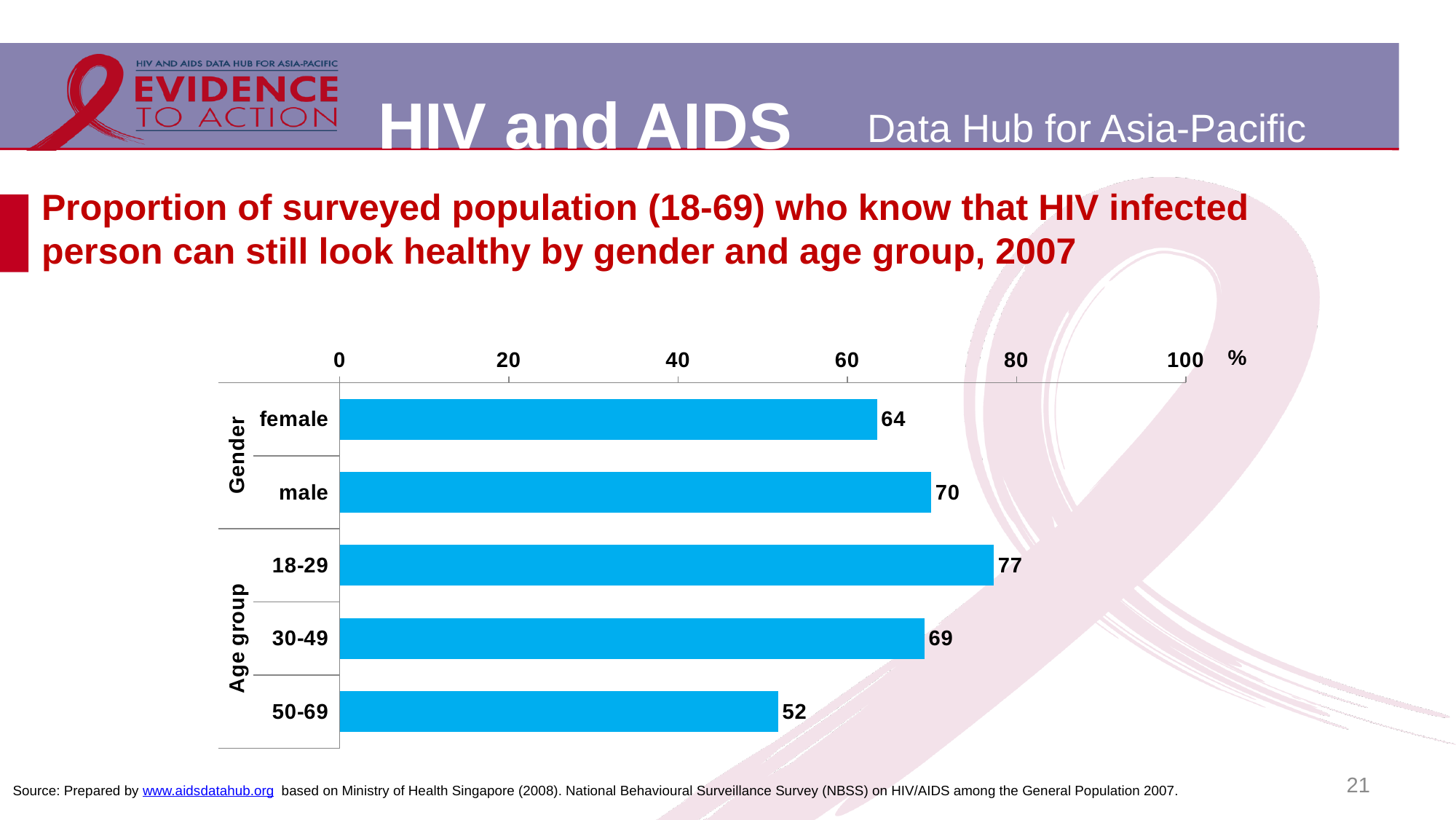
What is the difference between the values for male and female? 6 Is the value for the 18-29 age group greater or less than 60? greater Which category has the highest value? 18-29 What is the value for the 50-69 age group? 52 How many categories are plotted in the chart? 5 What is the value for the 30-49 age group? 69 What is the difference between the values for the 18-29 and 50-69 age groups? 25 Which is larger, the value for male or the value for female? male What is the value for female? 64 What kind of chart is shown on the slide? bar chart Which category has the lowest value? 50-69 What unit is shown at the end of the horizontal axis? %